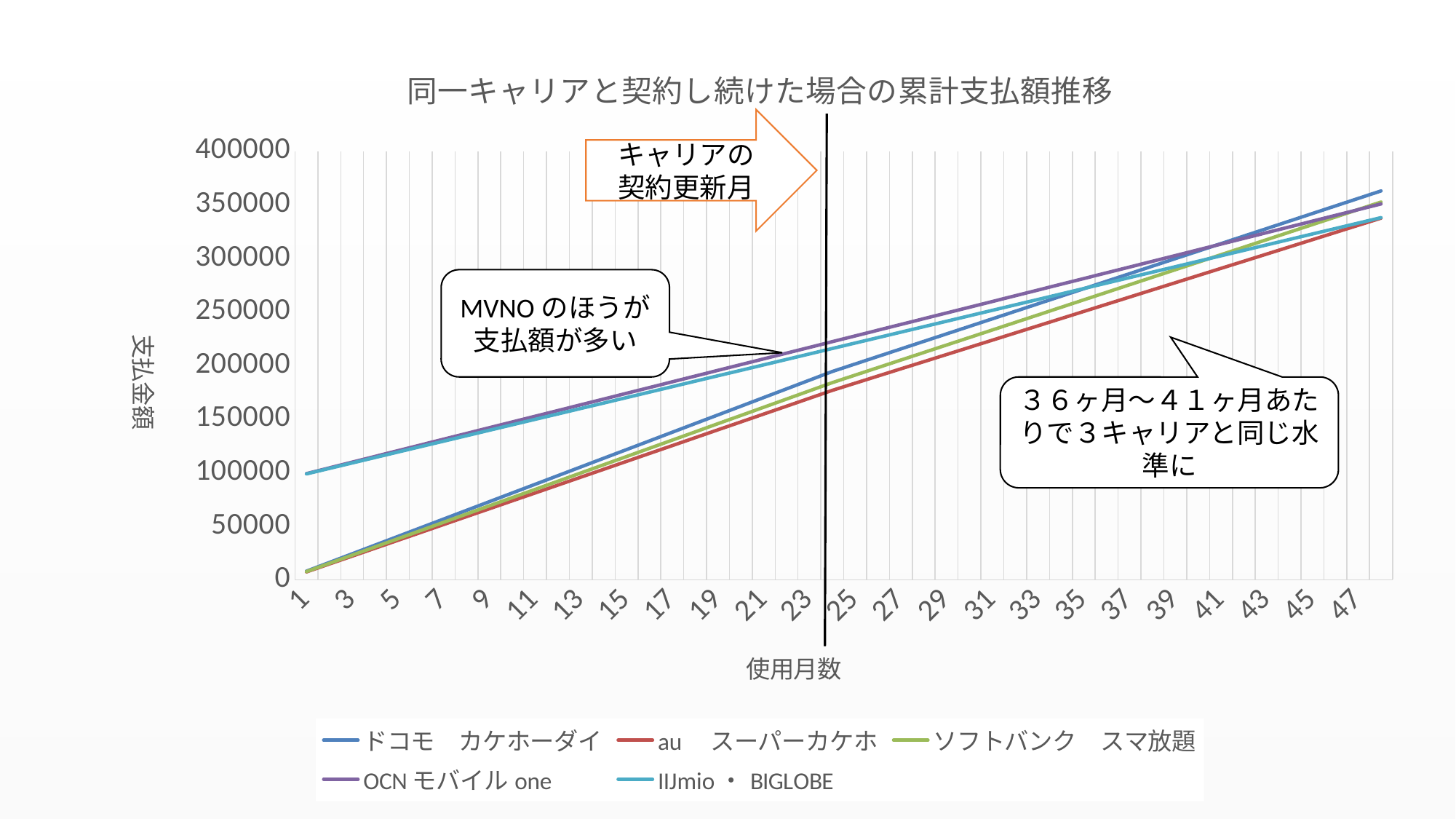
What kind of chart is shown on the slide? line chart Is the value for ソフトバンク スマ放題 at month 11 greater or less than 100000? less At month 47, which is larger: the value for ドコモ カケホーダイ or the value for au スーパーカケホ? ドコモ カケホーダイ Is the value for OCN モバイル one at month 1 greater or less than 50000? greater Is the value for ドコモ カケホーダイ at month 1 greater or less than 50000? less What is the title of the chart? 同一キャリアと契約し続けた場合の累計支払額推移 How many series does the legend list? 5 What is the label of the vertical axis? 支払金額 At month 11, which is larger: the value for OCN モバイル one or the value for ドコモ カケホーダイ? OCN モバイル one Do the values for ドコモ カケホーダイ rise or fall as the number of months increases? rise